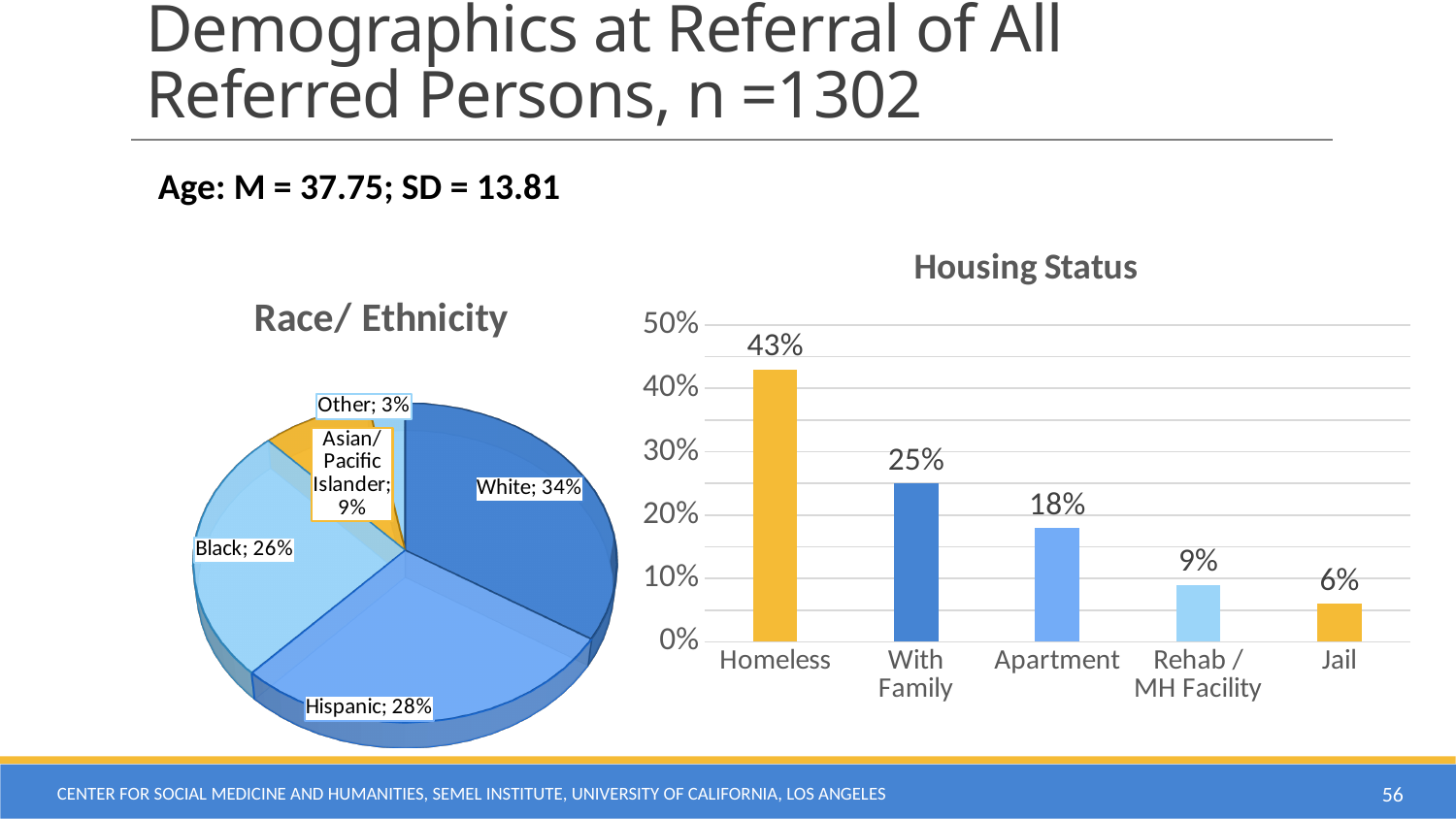
In the Housing Status chart, which is larger, Rehab / MH Facility or Jail? Rehab / MH Facility In the Race/ Ethnicity chart, what is the difference between the Hispanic and Black percentages? 2% In the Housing Status chart, what is the value for With Family? 25% In the Race/ Ethnicity chart, what percentage is shown for Asian/Pacific Islander? 9% In the Race/ Ethnicity chart, which category has the largest slice? White In the Race/ Ethnicity chart, what percentage is shown for White? 34% In the Race/ Ethnicity chart, how many slices does the pie have? 5 What kind of chart is the Housing Status chart? Bar chart In the Race/ Ethnicity chart, which category has the smallest slice? Other In the Housing Status chart, which category has the lowest value? Jail In the Housing Status chart, what is the difference between Homeless and Apartment? 25% In the Housing Status chart, which category has the highest value? Homeless